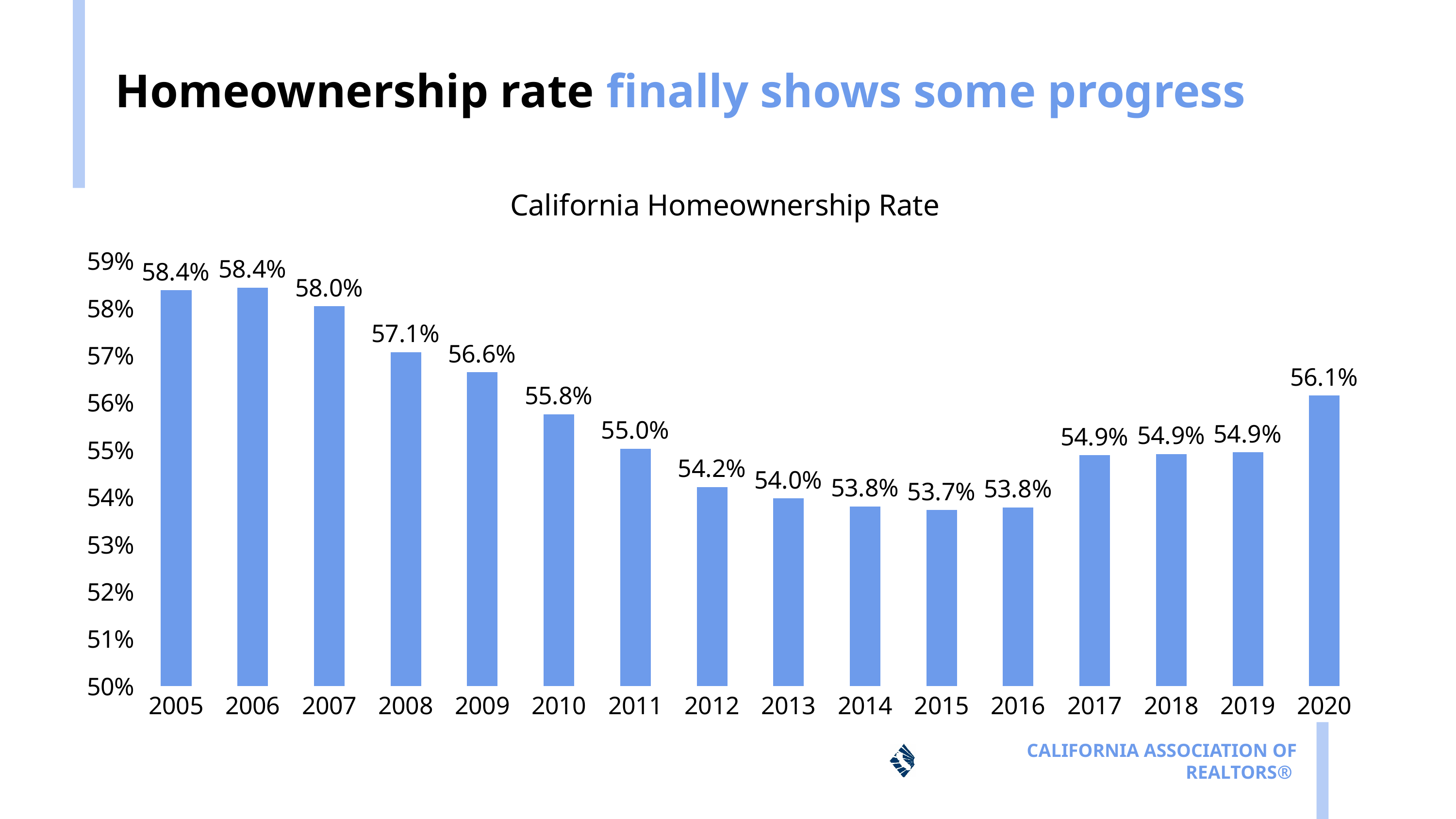
What is the difference between the homeownership rate in 2020 and in 2019? 1.2% How many years are shown on the x axis of the chart? 16 Do the homeownership rates rise or fall from 2005 to 2015? fall What kind of chart is shown on the slide? bar chart What is the California homeownership rate for 2020? 56.1% What is the California homeownership rate for 2008? 57.1% What is the California homeownership rate for 2015? 53.7% Which is larger, the homeownership rate in 2010 or in 2020? 2020 What is the title of the chart? California Homeownership Rate Which year has the lowest homeownership rate? 2015 Is the homeownership rate for 2012 greater or less than 55%? less What is the difference between the homeownership rate in 2005 and in 2015? 4.7%